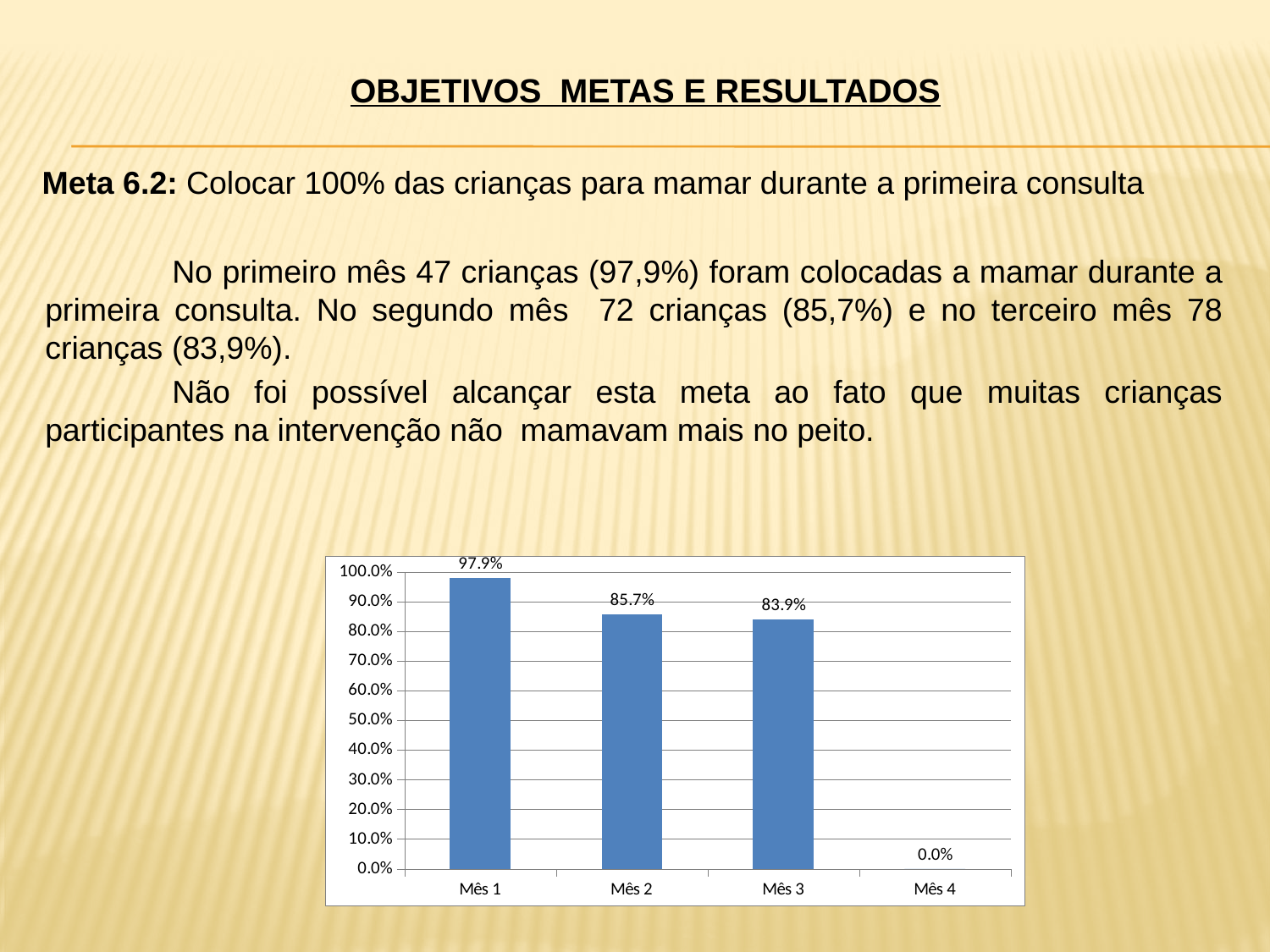
Which category has the highest value? Mês 1 How many categories are shown on the x axis? 4 Which category has the lowest value? Mês 4 What is the difference between the values for Mês 2 and Mês 3? 1.8% What is the value for Mês 4? 0.0% Which is larger, the value for Mês 1 or the value for Mês 3? Mês 1 What is the difference between the values for Mês 1 and Mês 2? 12.2% What kind of chart is shown on the slide? bar chart What is the value for Mês 3? 83.9% Is the value for Mês 2 greater or less than 90.0%? less What is the value for Mês 1? 97.9% What is the value for Mês 2? 85.7%